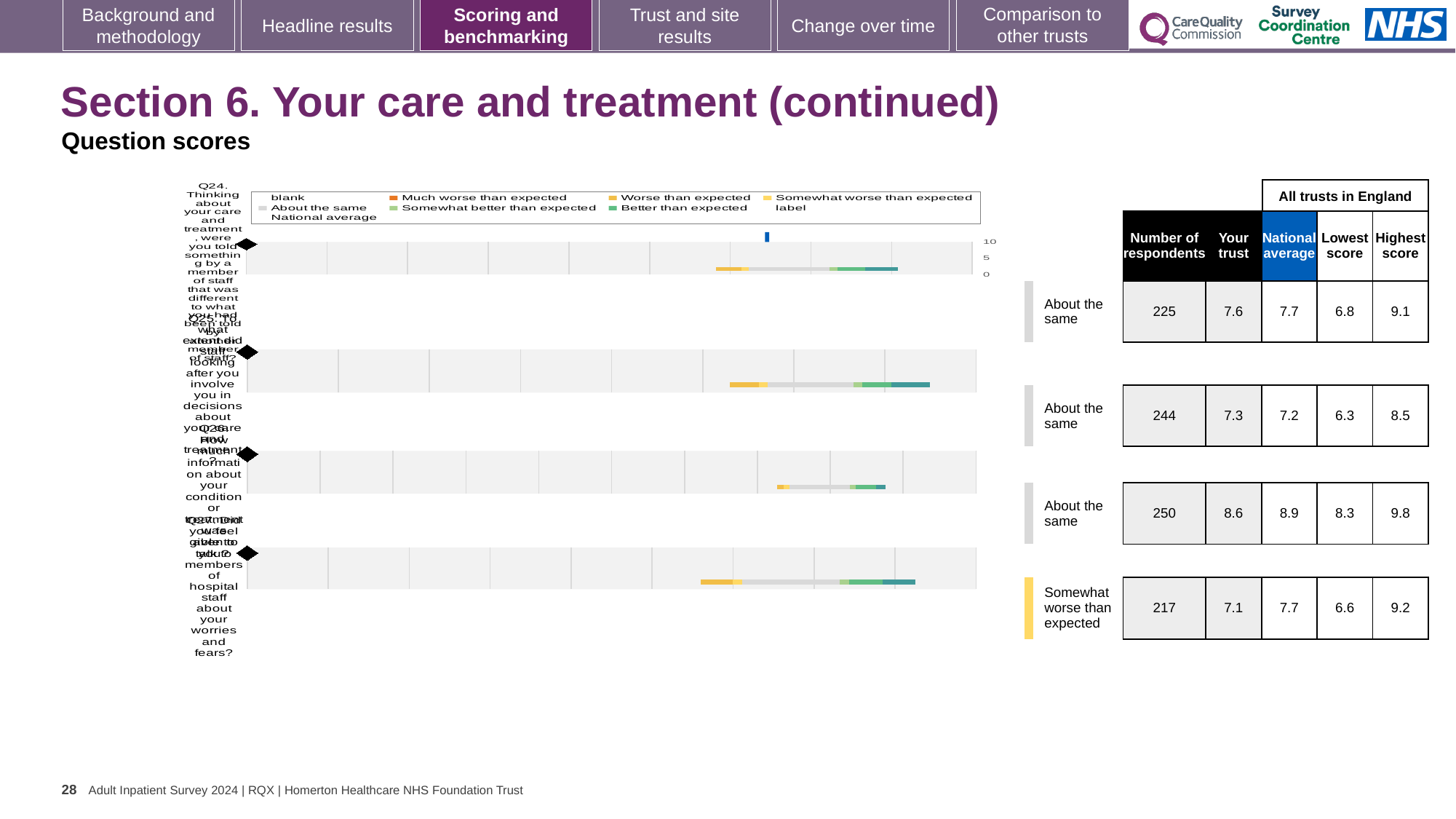
How many questions (rows) are shown in the question scores chart? 4 What kind of chart is used to show the question scores on this slide? bar chart For the third row (Q26), what is the difference between the highest score and the lowest score? 1.5 In the table beside the chart, what is the 'Your trust' score for the third row (Q26)? 8.6 In the table beside the chart, what is the number of respondents for the first row (Q24)? 225 What benchmark category is shown for the fourth row (Q27)? Somewhat worse than expected Which row has the lowest number of respondents in the table beside the chart? Q27 (217) In the table beside the chart, what is the national average for the first row (Q24)? 7.7 How many of the four rows are rated 'About the same'? 3 Which row has the highest 'Your trust' score in the table beside the chart? Q26 (8.6) For the second row (Q25), which is larger: the 'Your trust' score or the national average? Your trust (7.3) For the fourth row (Q27), how much lower is the 'Your trust' score than the national average? 0.6